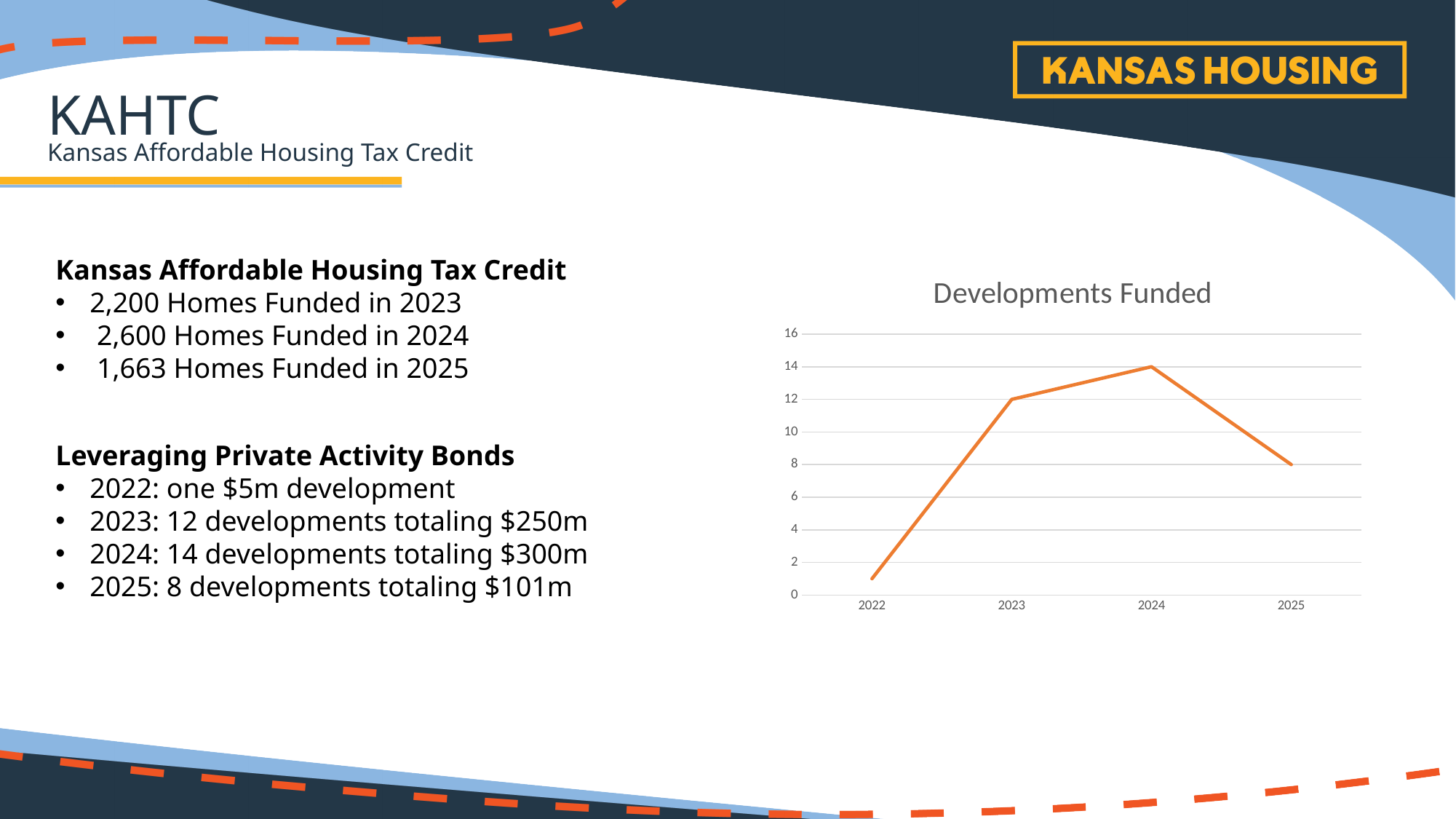
What is the value for 2025 on the Developments Funded chart? 8 What is the title of the chart? Developments Funded Which year has the lowest value on the Developments Funded chart? 2022 What is the difference between the 2024 and 2025 values on the Developments Funded chart? 6 What is the value for 2023 on the Developments Funded chart? 12 Which year has the highest value on the Developments Funded chart? 2024 What is the value for 2024 on the Developments Funded chart? 14 What kind of chart is shown on the slide? line chart Is the value for 2022 on the Developments Funded chart greater or less than 2? less How does the line on the Developments Funded chart change from 2024 to 2025? it falls Which is larger on the Developments Funded chart, the value for 2023 or the value for 2025? 2023 How many years are plotted on the Developments Funded chart? 4